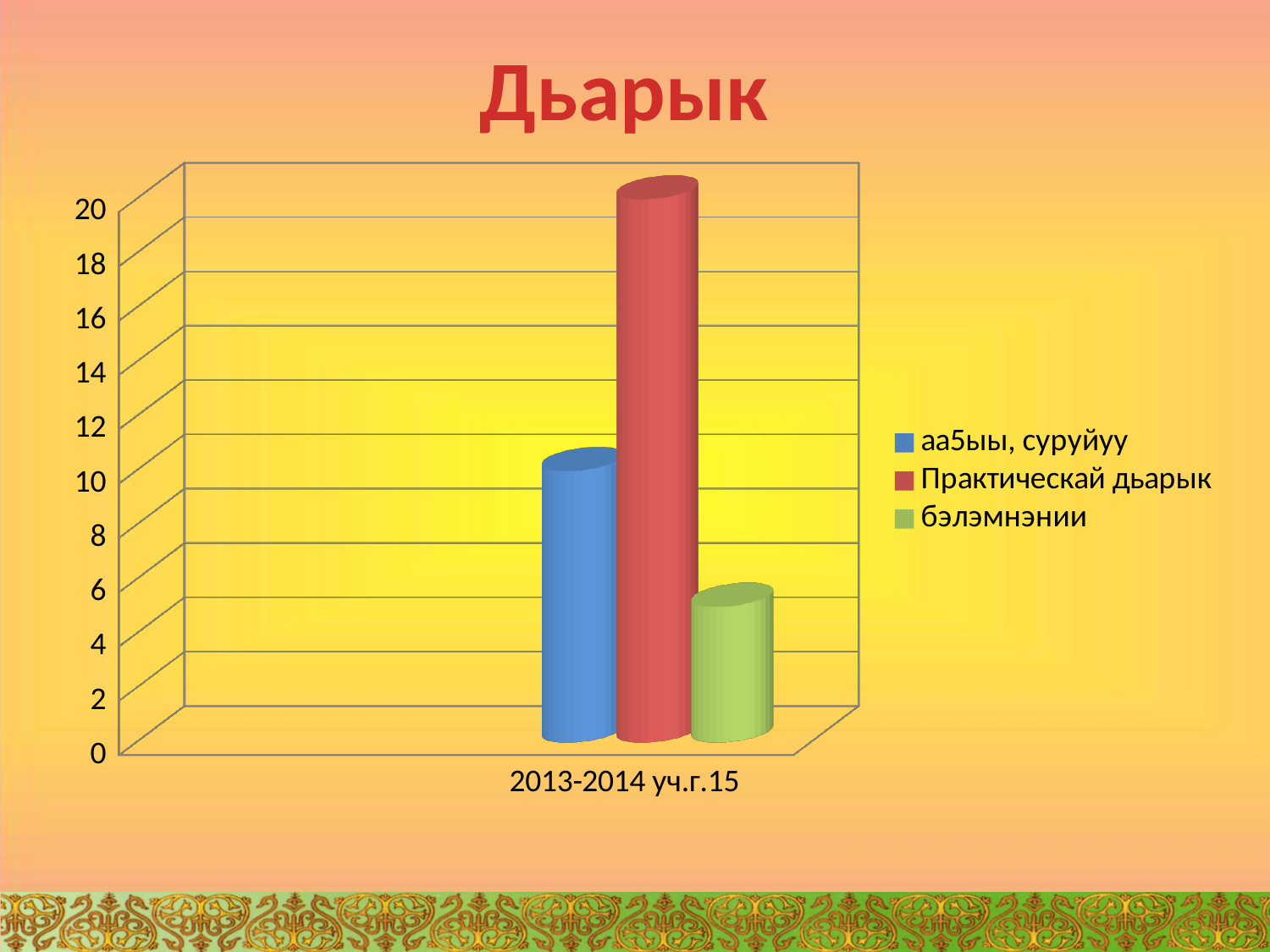
What is the category label on the x axis? 2013-2014 уч.г.15 How many series does the legend list? 3 What is the title of the chart? Дьарык Is the value for аа5ыы, суруйуу greater or less than 14? less How many categories are shown on the x axis? 1 Which is larger, the value for аа5ыы, суруйуу or the value for бэлэмнэнии? аа5ыы, суруйуу What kind of chart is shown on the slide? bar chart Which series has the highest value? Практическай дьарык Is the value for аа5ыы, суруйуу greater or less than 6? greater Is the value for бэлэмнэнии greater or less than 8? less Which series has the lowest value? бэлэмнэнии